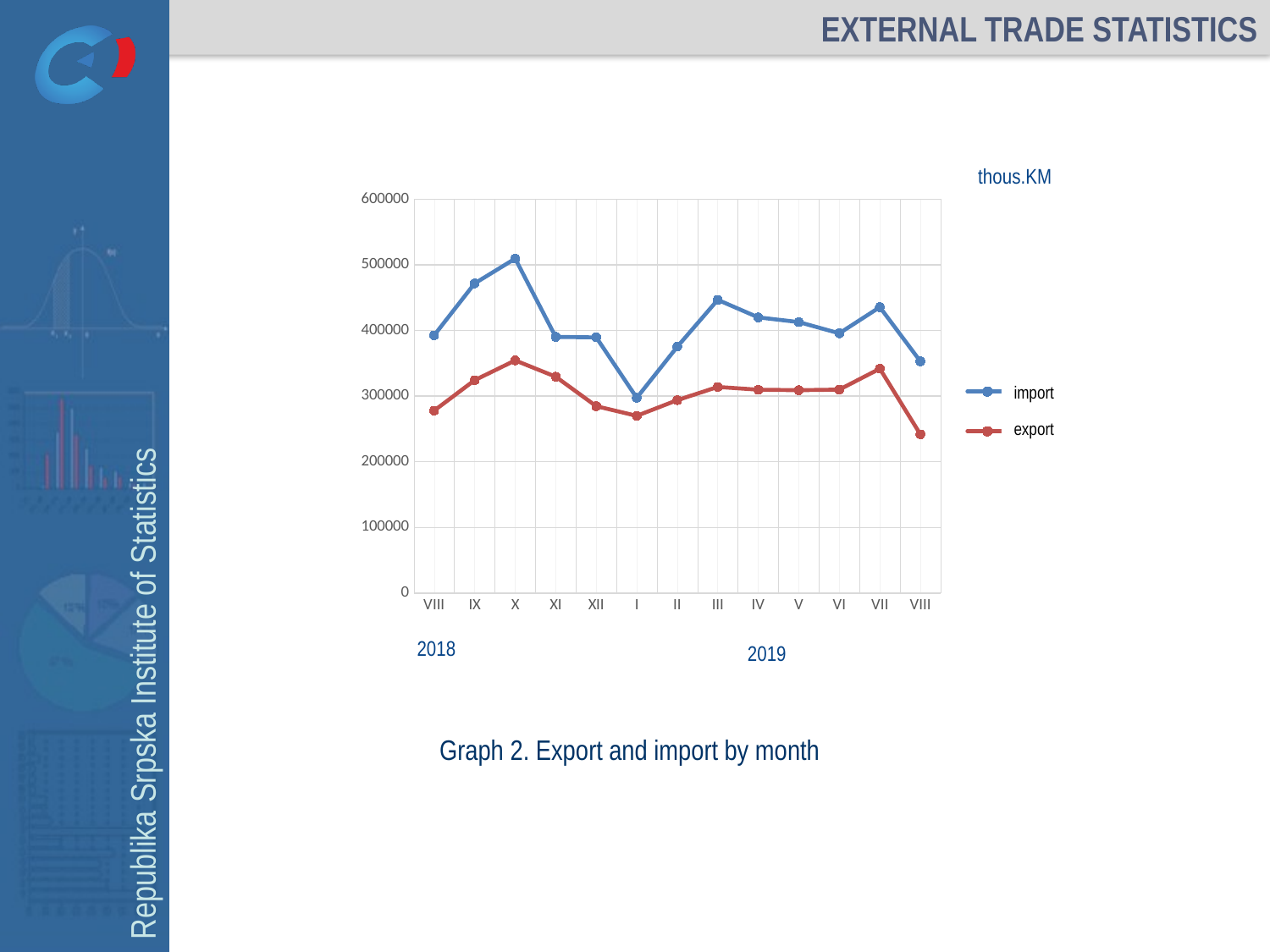
What unit is stated above the chart? thous.KM In which month does the import series reach its highest value? X (2018) Is the import value for X 2018 greater or less than 500000? greater In which month does the export series reach its lowest value? VIII (2019) How many series does the legend list? 2 How many monthly points are plotted along the x axis? 13 In which month does the export series reach its highest value? X (2018) Does the import series rise or fall from X 2018 to I 2019? fall What kind of chart is shown on the slide? line chart Which is larger in III 2019, import or export? import In which month does the import series reach its lowest value? I (2019) Is the export value for VIII 2019 greater or less than 300000? less